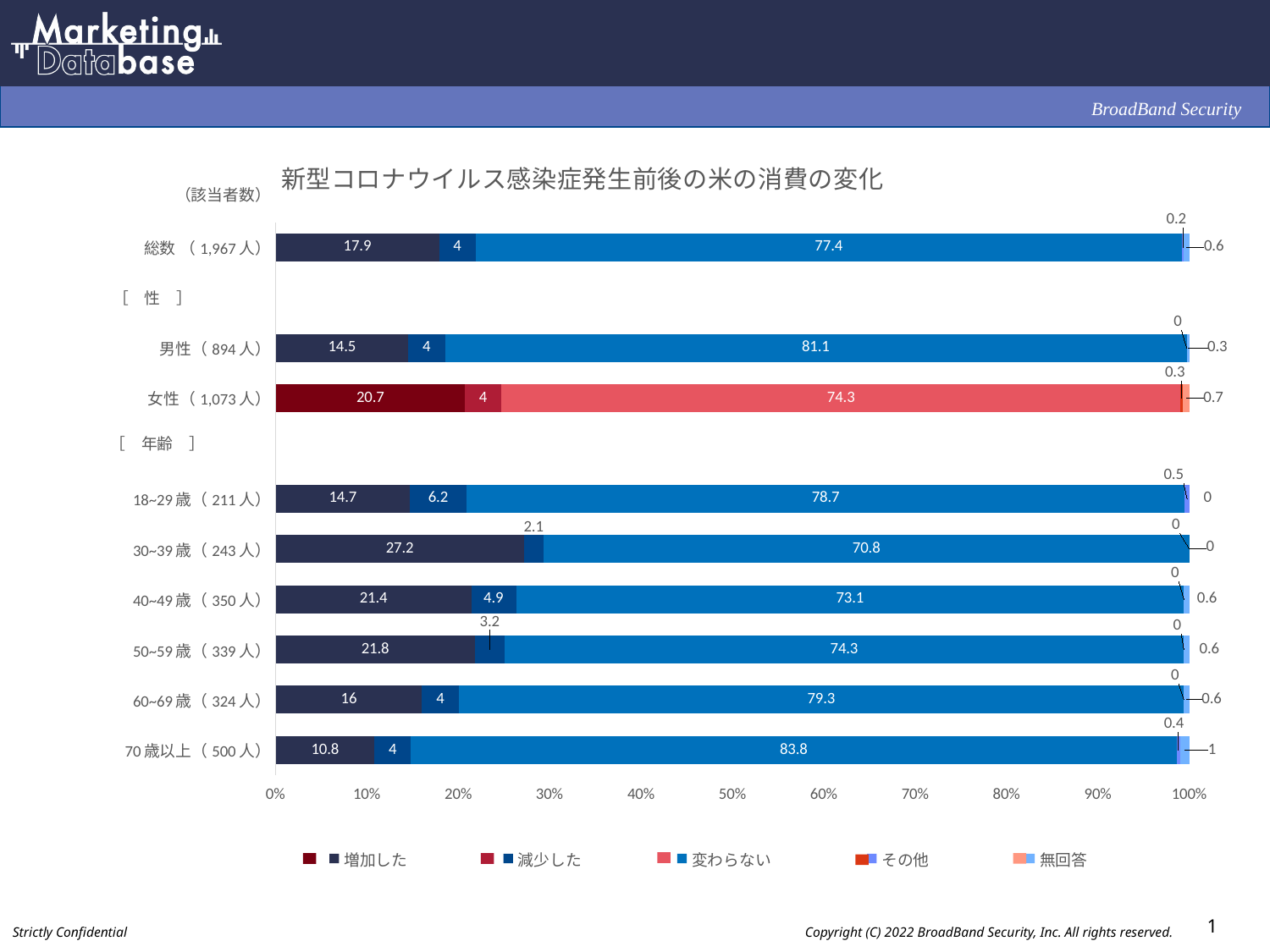
How many series does the legend list? 5 What is the value of 増加した for 30~39歳? 27.2 What is the difference between the 増加した values for 女性 and 男性? 6.2 What kind of chart is shown on the slide? Stacked bar chart Which category has the lowest value for 変わらない? 30~39歳 Which is larger, the 変わらない value for 男性 or for 女性? 男性 What is the title of the chart? 新型コロナウイルス感染症発生前後の米の消費の変化 What is the value of 変わらない for 70歳以上? 83.8 Which category has the highest value for 増加した? 30~39歳 How many categories (bars) are plotted in the chart? 9 What is the value of 減少した for 18~29歳? 6.2 What is the value of 無回答 for 女性? 0.7